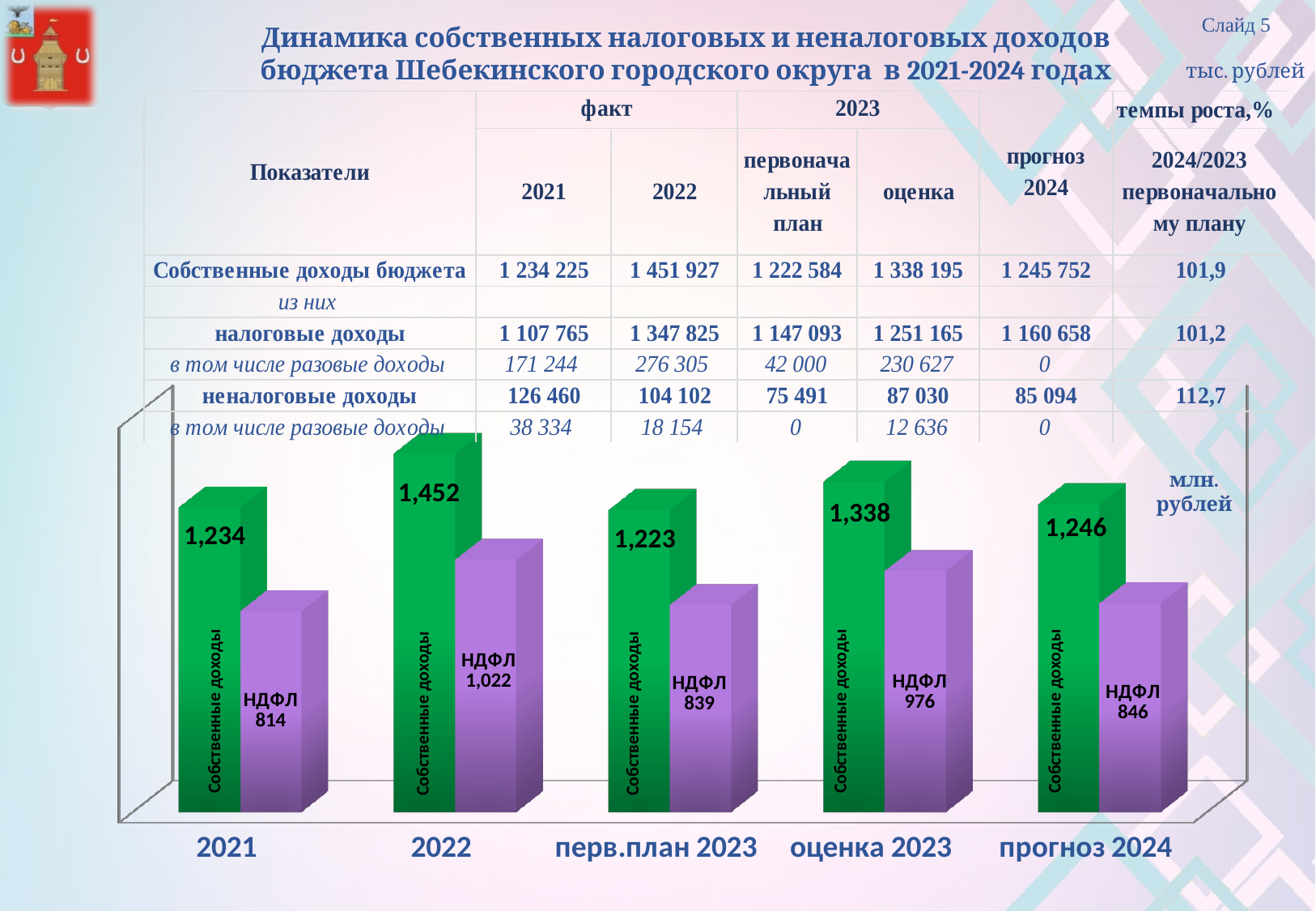
What is the value of Собственные доходы for прогноз 2024 on the chart? 1,246 What is the value of НДФЛ for оценка 2023 on the chart? 976 Does the value of Собственные доходы rise or fall from 2022 to перв.план 2023 on the chart? fall Which category has the lowest value of НДФЛ on the chart? 2021 What is the difference between Собственные доходы and НДФЛ for перв.план 2023 on the chart? 384 What is the value of НДФЛ for 2022 on the chart? 1,022 Which category has the highest value of Собственные доходы on the chart? 2022 What is the value of Собственные доходы for 2021 on the chart? 1,234 Which is larger on the chart: НДФЛ for оценка 2023 or НДФЛ for прогноз 2024? оценка 2023 What unit is indicated for the values on the chart? млн. рублей How many categories are shown on the x axis of the chart? 5 What type of chart is shown on the slide? bar chart